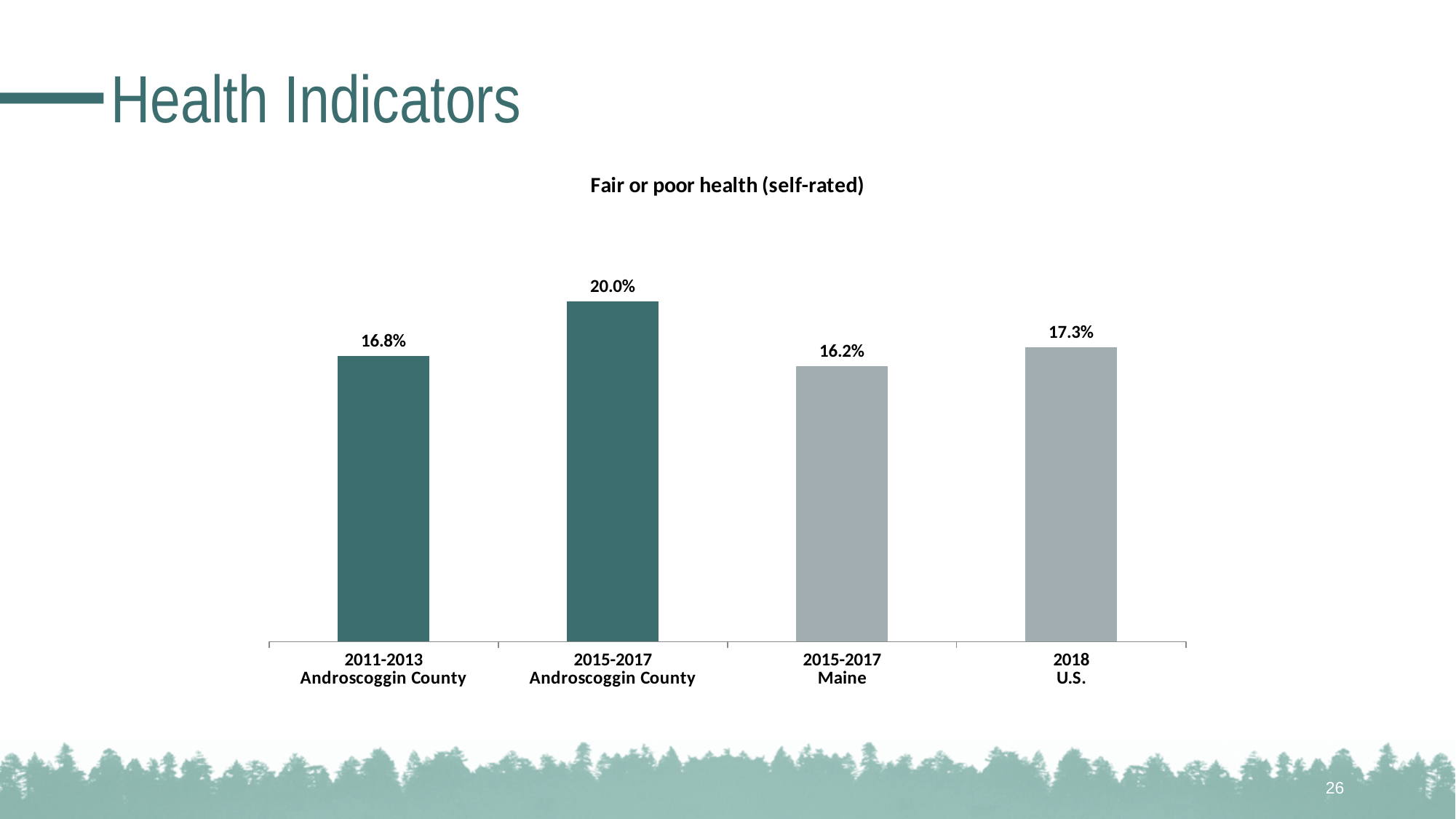
What is the value for 2011-2013 Androscoggin County? 16.8% Which is larger, the value for 2018 U.S. or the value for 2015-2017 Maine? 2018 U.S. What is the value for 2015-2017 Androscoggin County in the Fair or poor health (self-rated) chart? 20.0% What is the difference between the 2018 U.S. value and the 2011-2013 Androscoggin County value? 0.5% Which category has the highest value? 2015-2017 Androscoggin County What is the value for 2018 U.S.? 17.3% What is the value for 2015-2017 Maine? 16.2% What is the title of the chart? Fair or poor health (self-rated) What is the difference between the 2015-2017 Androscoggin County value and the 2015-2017 Maine value? 3.8% How many categories are shown in the chart? 4 Which category has the lowest value? 2015-2017 Maine What kind of chart is shown on the slide? Bar chart